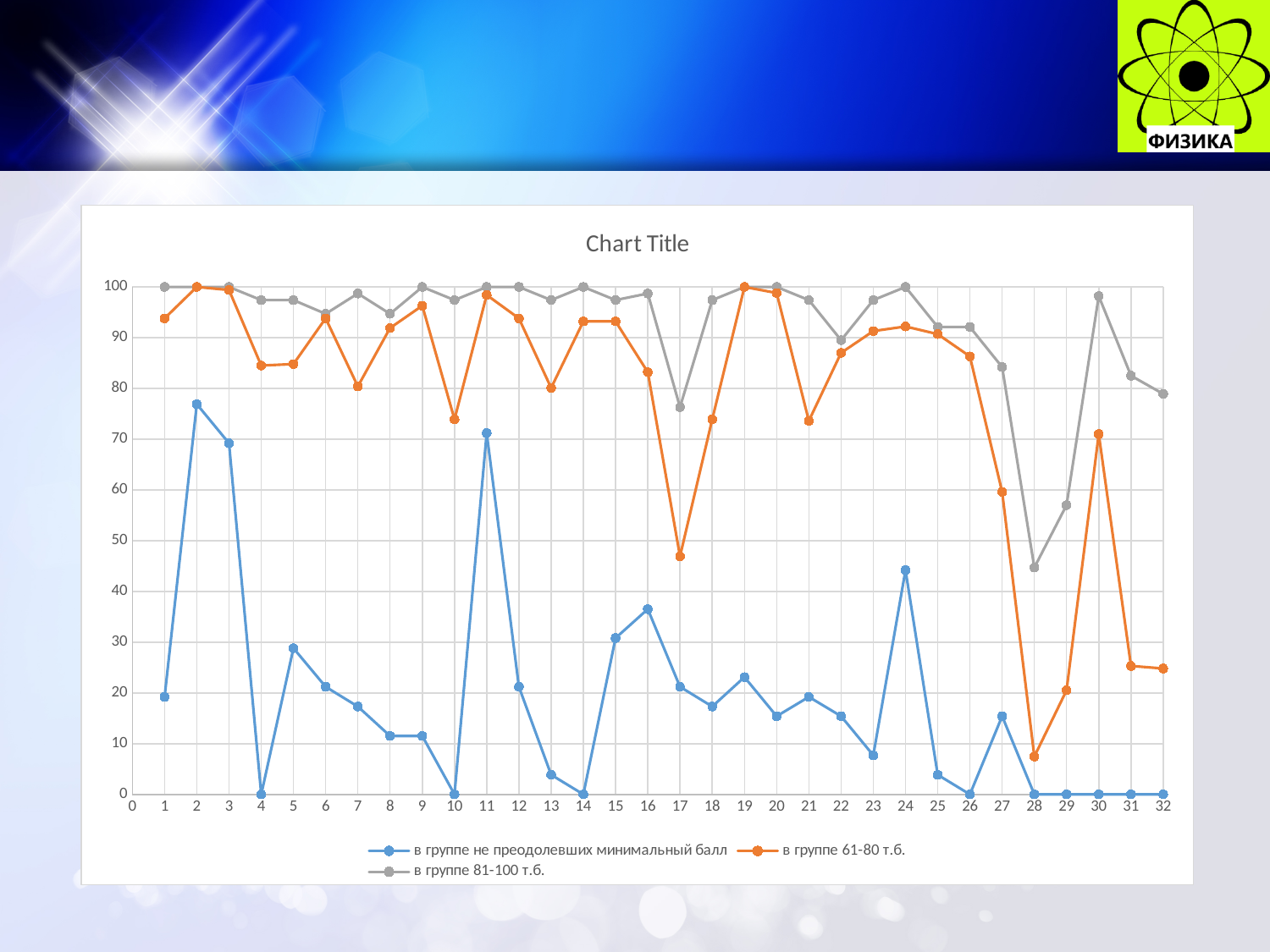
What is the value for x = 28 in the series 'в группе не преодолевших минимальный балл'? 0 How many series does the legend list? 3 Does the series 'в группе 81-100 т.б.' rise or fall from x = 30 to x = 32? fall Is the value for x = 2 in the series 'в группе не преодолевших минимальный балл' greater or less than 70? greater What kind of chart is shown on the slide? line chart At which x value does the series 'в группе 61-80 т.б.' reach its lowest point? 28 How many data points does each series have along the x axis (from 1 to 32)? 32 Is the value for x = 17 in the series 'в группе 61-80 т.б.' greater or less than 50? less Is the value for x = 28 in the series 'в группе 81-100 т.б.' greater or less than 50? less What is the title of the chart? Chart Title At which x value does the series 'в группе не преодолевших минимальный балл' reach its highest point? 2 At x = 17, which series has the larger value: 'в группе 61-80 т.б.' or 'в группе 81-100 т.б.'? в группе 81-100 т.б.